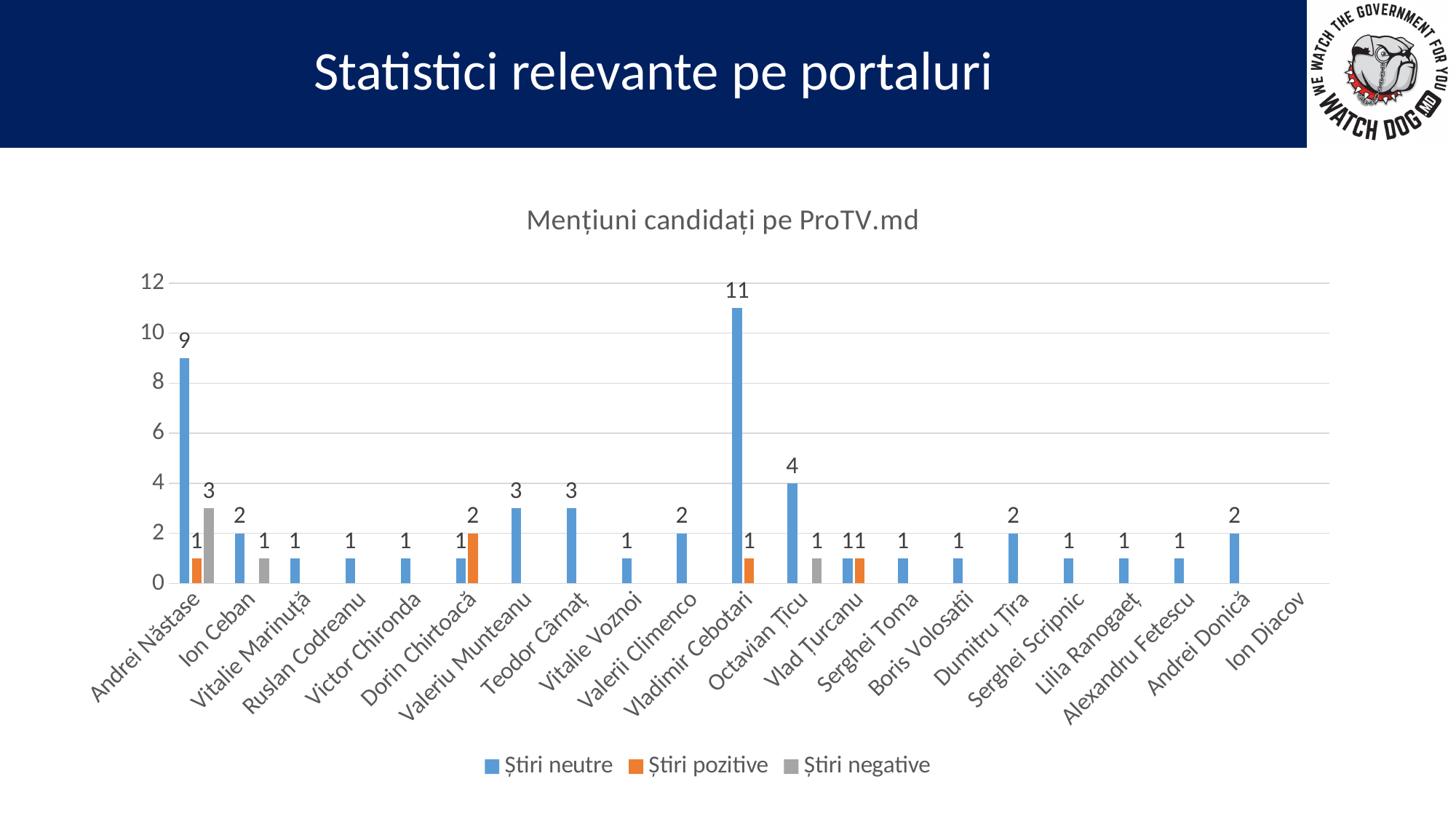
What is the value of Știri negative for Andrei Năstase? 3 What kind of chart is shown on the slide? Bar chart Which colour represents Știri pozitive in the chart? Orange What is the value of Știri neutre for Vladimir Cebotari? 11 What is the difference between the Știri neutre values for Vladimir Cebotari and Andrei Năstase? 2 Which is larger: Știri neutre for Octavian Țîcu or Știri neutre for Valeriu Munteanu? Octavian Țîcu How many series does the legend list? 3 What is the title of the chart? Mențiuni candidați pe ProTV.md What is the value of Știri neutre for Octavian Țîcu? 4 How many candidates are listed on the x axis? 21 What is the value of Știri pozitive for Dorin Chirtoacă? 2 Which candidate has the highest value for Știri neutre? Vladimir Cebotari